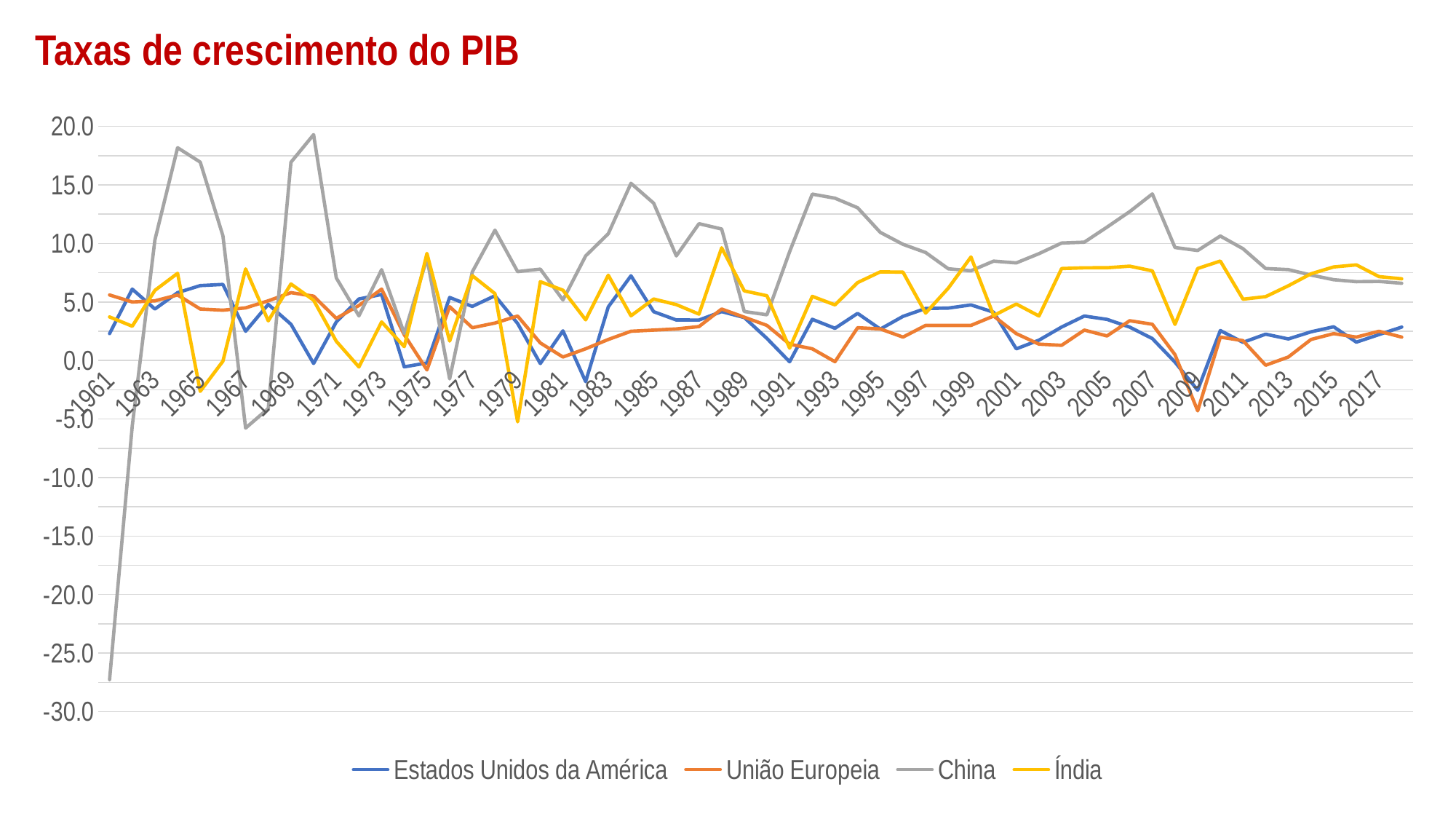
Which series reaches the lowest value anywhere on the chart? China Is the value for China in 1970 greater or less than 15.0? greater Is the value for Estados Unidos da América in 2009 greater or less than 0.0? less Which series is drawn in grey? China How many series does the legend list? 4 In 2007, which is higher: China or Estados Unidos da América? China What is the title of the chart? Taxas de crescimento do PIB What kind of chart is shown on the slide? line chart Is the value for Índia in 1979 greater or less than 0.0? less Which series reaches the highest value anywhere on the chart? China Does the value for China rise or fall from 1961 to 1964? rise